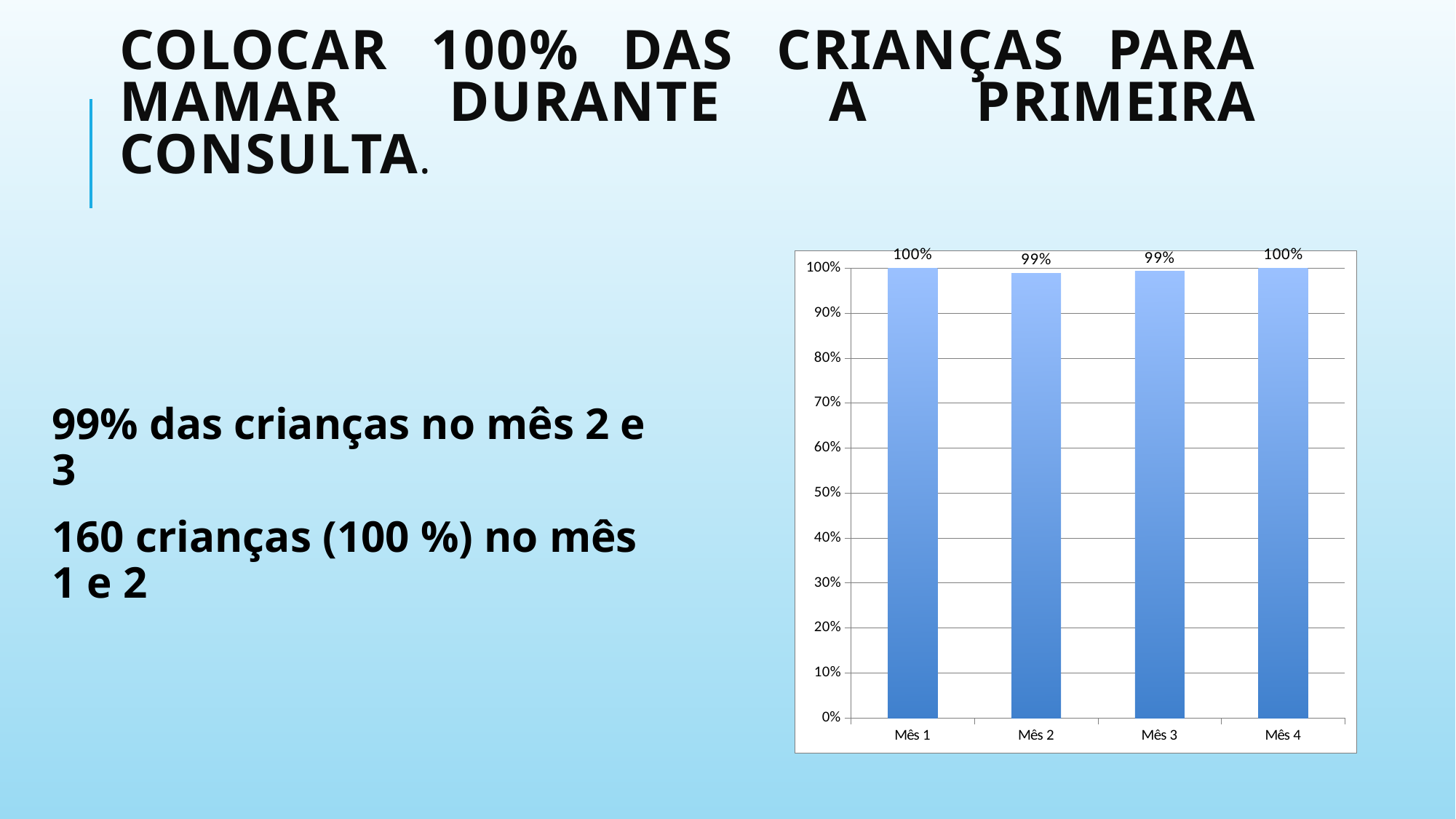
What is the value for Mês 4? 100% What is the value for Mês 1? 100% What kind of chart is shown on the slide? Bar chart How many categories are shown on the x axis of the chart? 4 What is the highest value shown in the chart? 100% Which is larger, the value for Mês 4 or the value for Mês 3? Mês 4 What is the difference between the values for Mês 1 and Mês 2? 1% What is the lowest value shown in the chart? 99% What is the value for Mês 3? 99% What colour are the bars in the chart? Blue Is the value for Mês 3 greater or less than 90%? greater What is the value for Mês 2? 99%